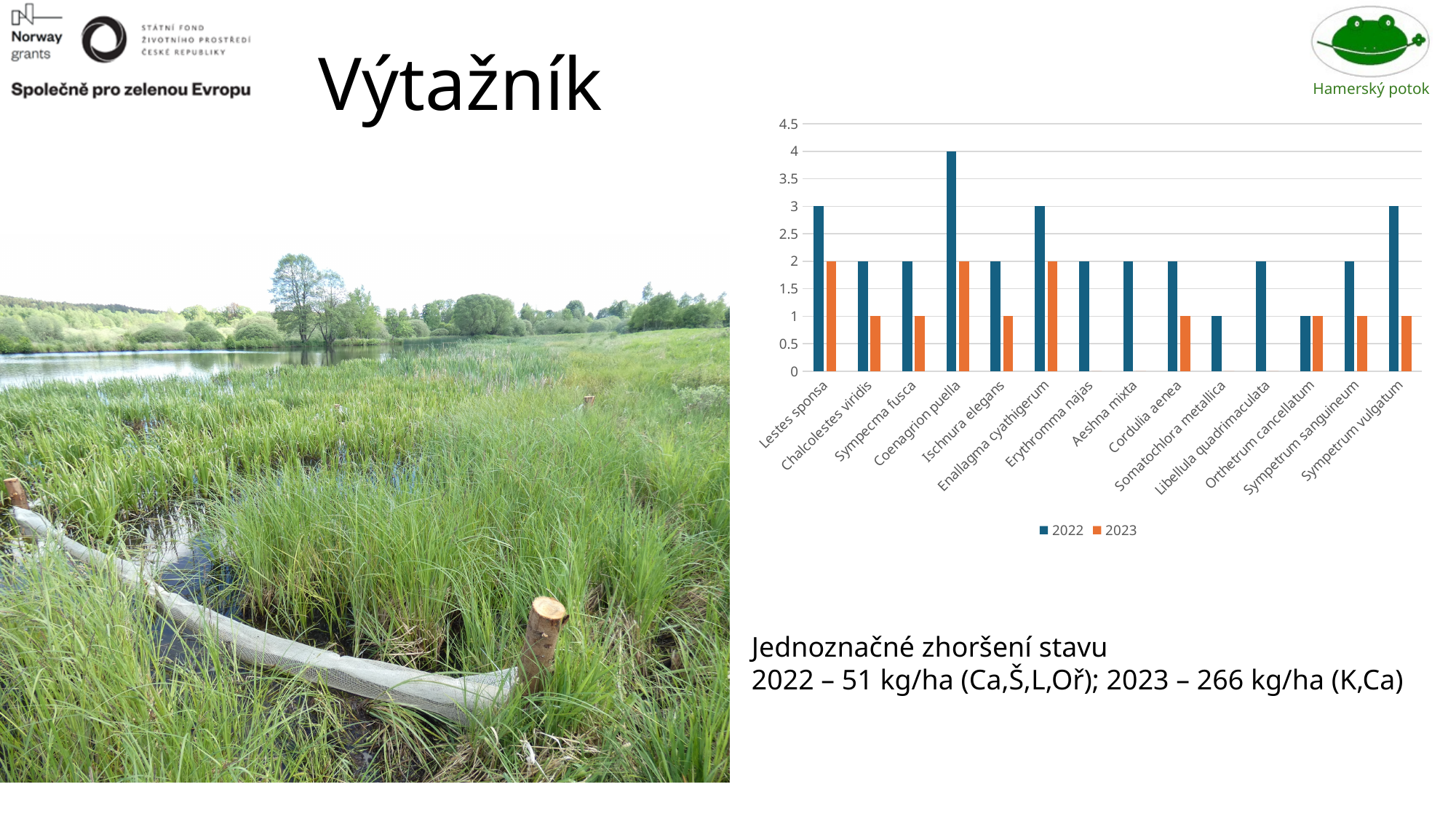
What is the 2023 value for Orthetrum cancellatum? 1 What is the difference between the 2022 and 2023 values for Coenagrion puella? 2 What is the 2022 value for Sympetrum vulgatum? 3 What kind of chart is shown on the slide? bar chart Which species has the highest 2022 value? Coenagrion puella What is the 2023 value for Lestes sponsa? 2 What is the 2022 value for Coenagrion puella? 4 How many series does the chart legend list? 2 Which is larger for Sympetrum vulgatum, the 2022 value or the 2023 value? 2022 Which series is shown in orange in the chart legend? 2023 How many species categories are shown on the x axis of the chart? 14 Is the 2022 value for Enallagma cyathigerum greater or less than 2? greater